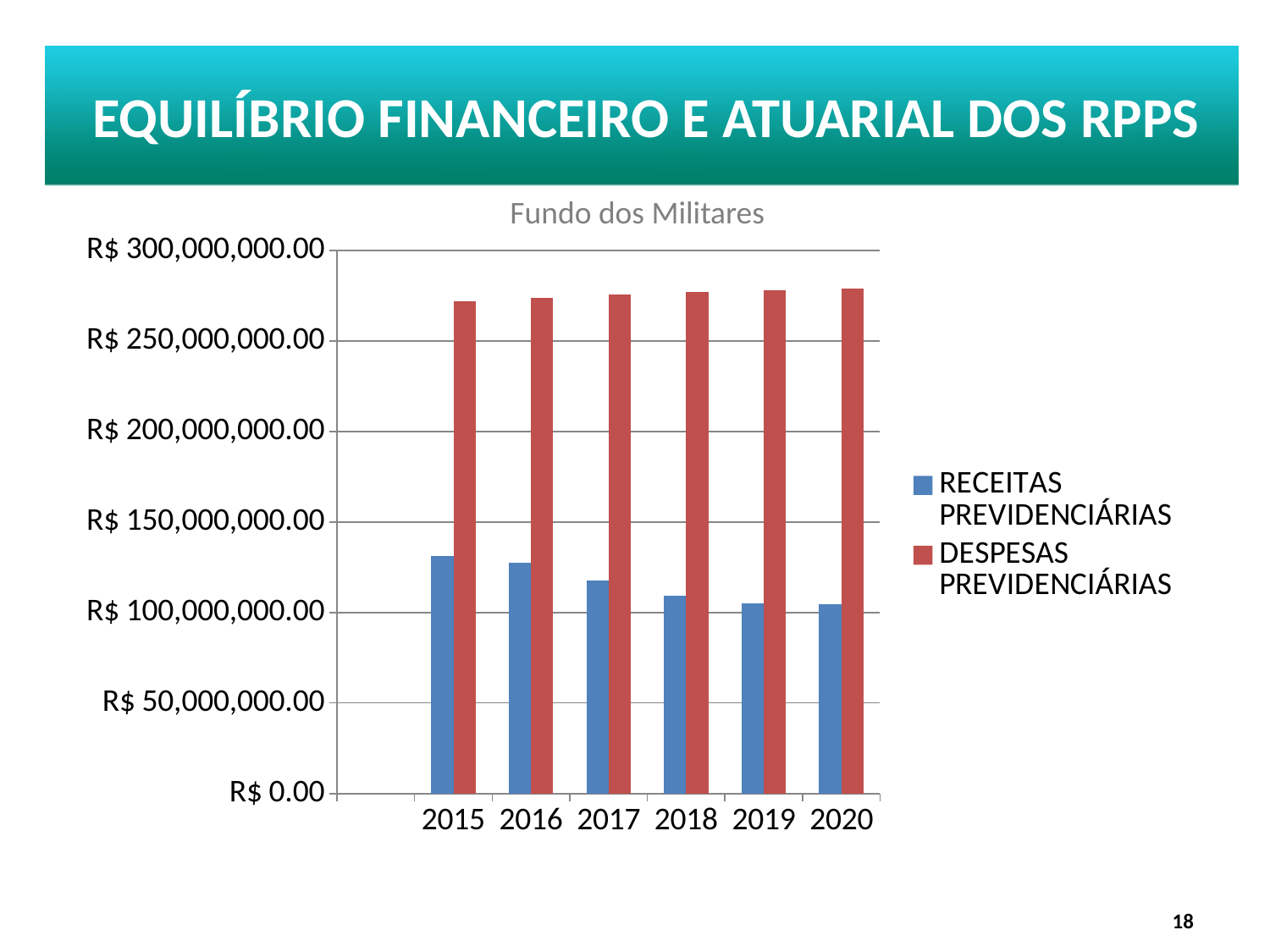
Do the DESPESAS PREVIDENCIÁRIAS values rise or fall from 2015 to 2020? rise How many series does the legend list? 2 How many years are shown on the x axis? 6 Is the value for RECEITAS PREVIDENCIÁRIAS in 2020 greater or less than R$ 150,000,000.00? less In 2018, which is larger: RECEITAS PREVIDENCIÁRIAS or DESPESAS PREVIDENCIÁRIAS? DESPESAS PREVIDENCIÁRIAS Which series is shown in red? DESPESAS PREVIDENCIÁRIAS Do the RECEITAS PREVIDENCIÁRIAS values rise or fall from 2015 to 2020? fall Is the value for RECEITAS PREVIDENCIÁRIAS in 2015 greater or less than R$ 100,000,000.00? greater What kind of chart is shown on the slide? bar chart What is the title of the chart? Fundo dos Militares Is the value for DESPESAS PREVIDENCIÁRIAS in 2015 greater or less than R$ 250,000,000.00? greater